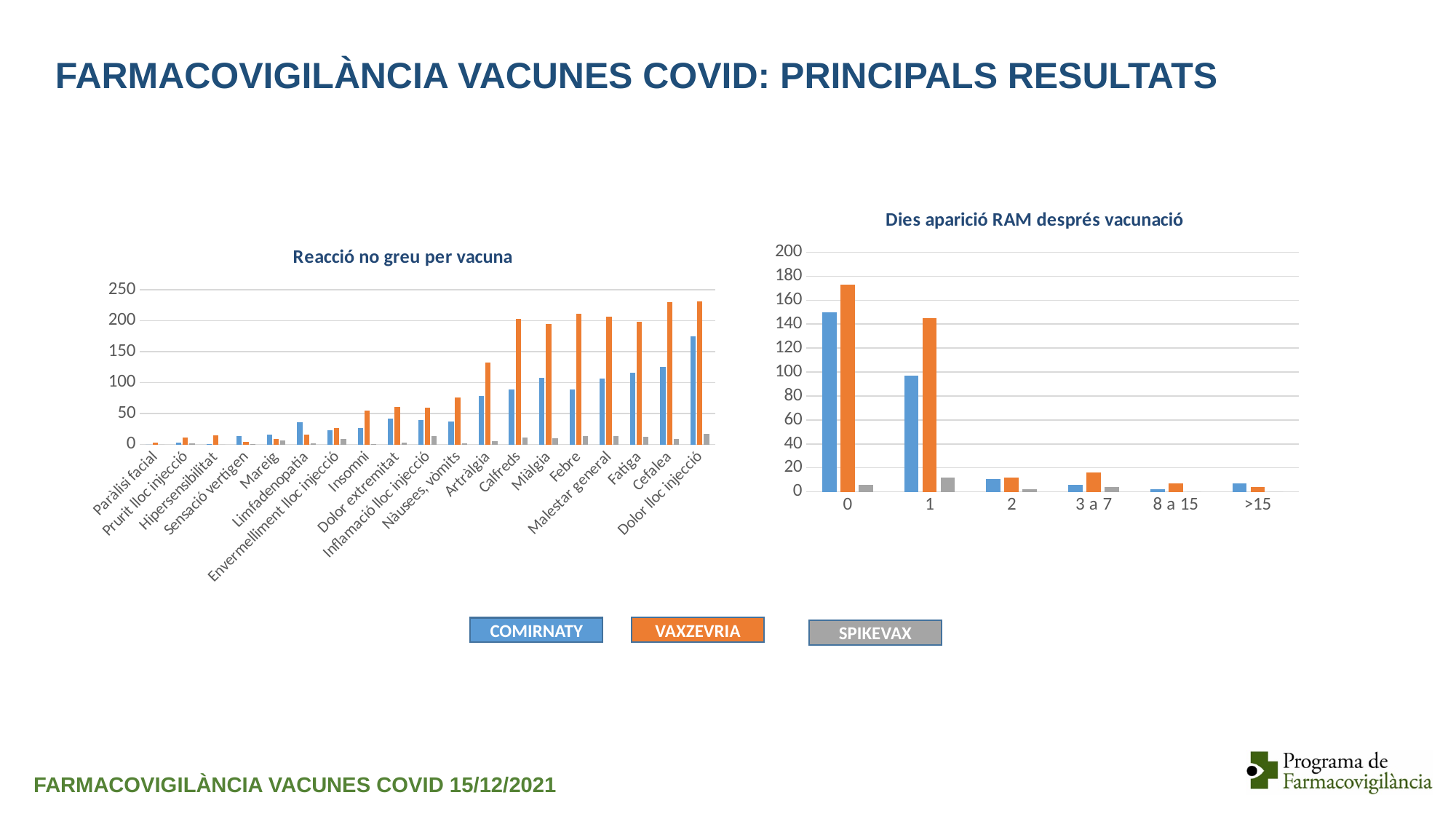
What kind of chart is the chart titled "Dies aparició RAM després vacunació"? bar chart In the chart titled "Reacció no greu per vacuna", is the COMIRNATY value for Artràlgia greater or less than 100? less In the chart titled "Dies aparició RAM després vacunació", how many categories are shown on the x axis? 6 In the chart titled "Reacció no greu per vacuna", is the VAXZEVRIA value for Dolor lloc injecció greater or less than 200? greater In the chart titled "Reacció no greu per vacuna", which category has the highest COMIRNATY value? Dolor lloc injecció In the chart titled "Dies aparició RAM després vacunació", which is larger for category 0: the COMIRNATY value or the VAXZEVRIA value? VAXZEVRIA In the chart titled "Dies aparició RAM després vacunació", do the VAXZEVRIA values generally rise or fall from left to right along the x axis? fall In the chart titled "Dies aparició RAM després vacunació", is the VAXZEVRIA value for category 2 greater or less than 40? less How many series does the legend list? 3 In the chart titled "Reacció no greu per vacuna", how many categories are shown on the x axis? 19